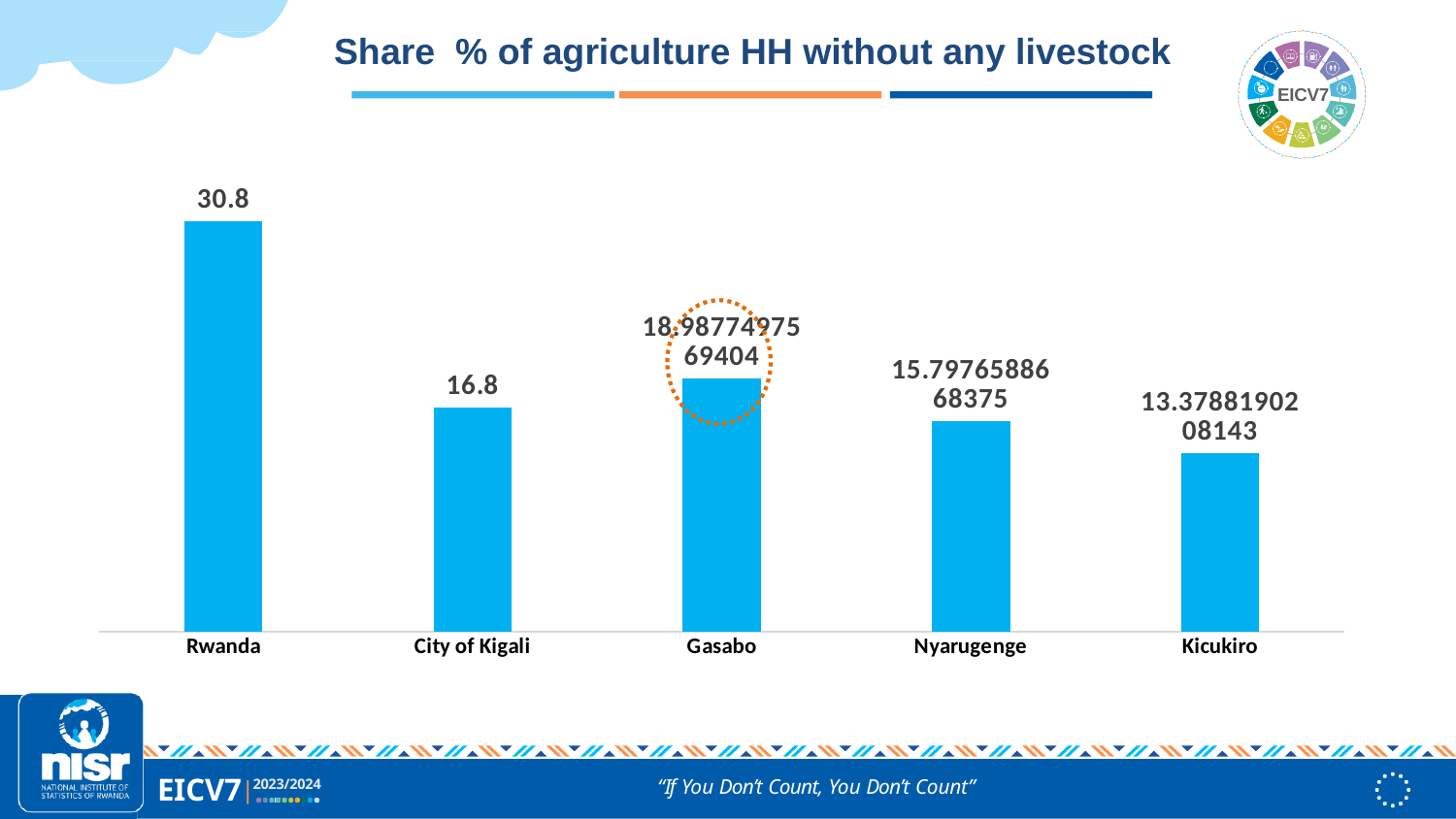
What is the value shown for Gasabo? 18.9877497569404 Which category has the lowest value? Kicukiro What kind of chart is shown on the slide? Bar chart Which is larger, the value for Gasabo or the value for Nyarugenge? Gasabo Which is larger, the value for City of Kigali or the value for Kicukiro? City of Kigali What is the value for Rwanda? 30.8 What is the title of the chart? Share % of agriculture HH without any livestock What is the difference between the values for Rwanda and City of Kigali? 14 How many categories are shown on the chart? 5 Which category has the highest value? Rwanda What is the value for City of Kigali? 16.8 What is the value shown for Kicukiro? 13.3788190208143